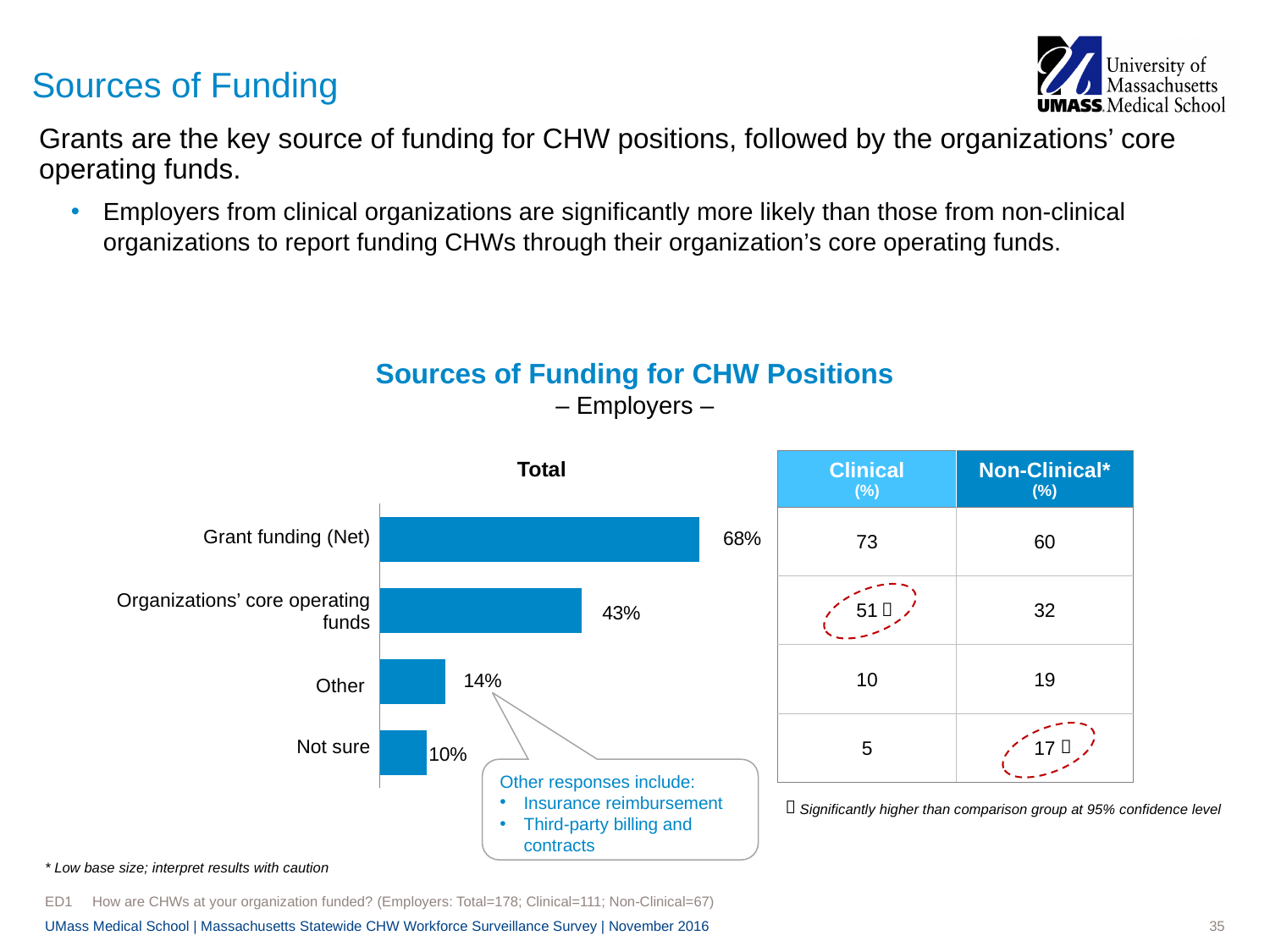
Which has a larger Total value, Other or Not sure? Other What type of chart is used to show the Total sources of funding for CHW positions? bar chart Which category has the lowest Total value? Not sure Which source of funding has the highest Total value? Grant funding (Net) What is the difference between the Total values for Grant funding (Net) and Organizations' core operating funds? 25% How many categories are shown in the bar chart? 4 What is the Total value for Organizations' core operating funds? 43% In the table next to the chart, what is the Clinical percentage for Grant funding (Net)? 73 What is the title of the chart? Sources of Funding for CHW Positions – Employers – What is the Total value for Not sure? 10% What is the Total value for Other? 14% What is the Total value for Grant funding (Net)? 68%